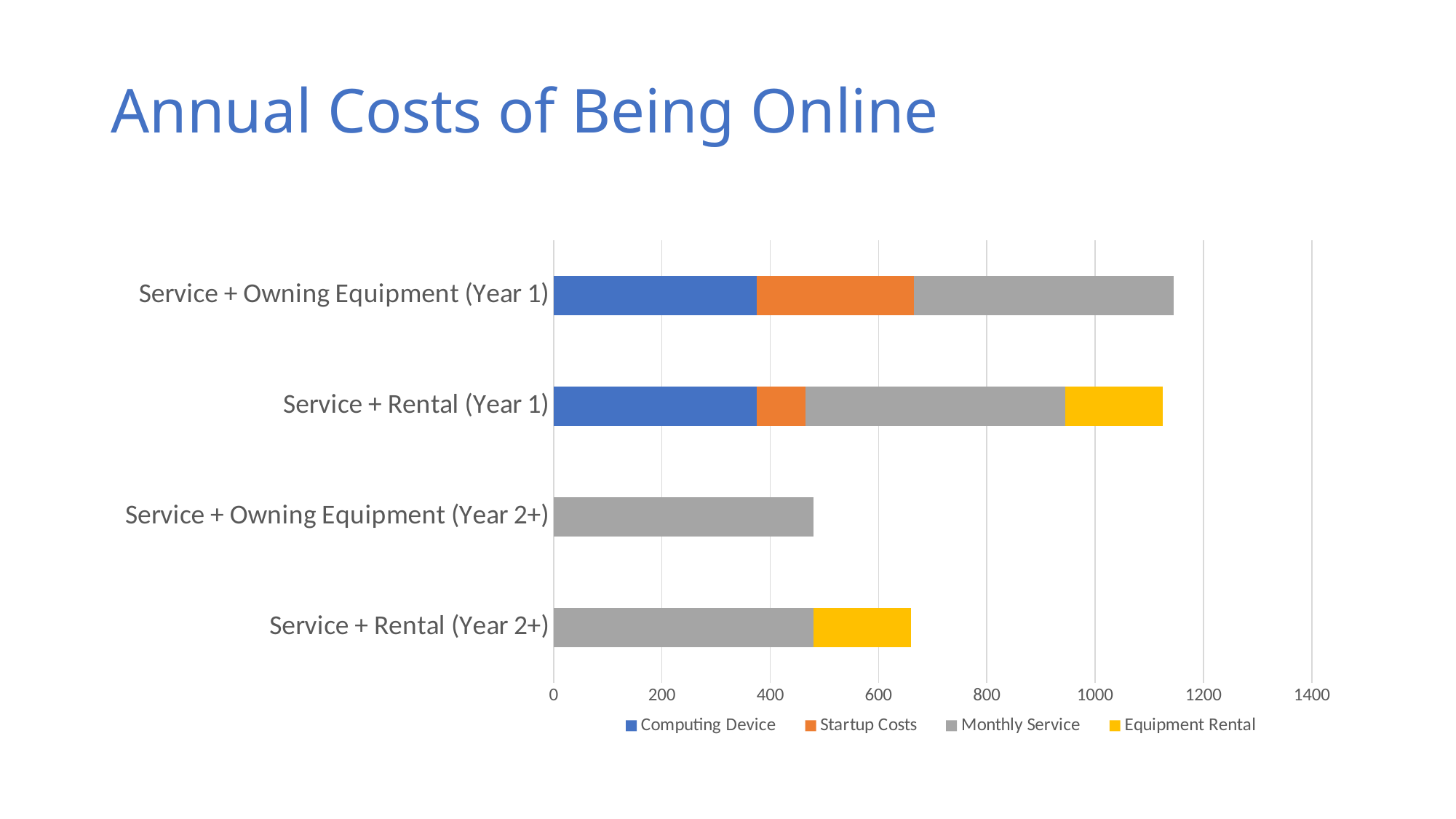
Which category has the lowest total bar length? Service + Owning Equipment (Year 2+) Is the total for Service + Owning Equipment (Year 2+) greater or less than 600? less Which has the larger total: Service + Owning Equipment (Year 1) or Service + Owning Equipment (Year 2+)? Service + Owning Equipment (Year 1) Which series is shown in yellow in the legend? Equipment Rental Is the total for Service + Rental (Year 1) greater or less than 1200? less Which has the larger total: Service + Rental (Year 2+) or Service + Owning Equipment (Year 2+)? Service + Rental (Year 2+) Is the total for Service + Owning Equipment (Year 1) greater or less than 1000? greater How many series does the legend list? 4 How many categories are plotted on the chart? 4 What kind of chart is shown on the slide? bar chart What is the title of the slide? Annual Costs of Being Online